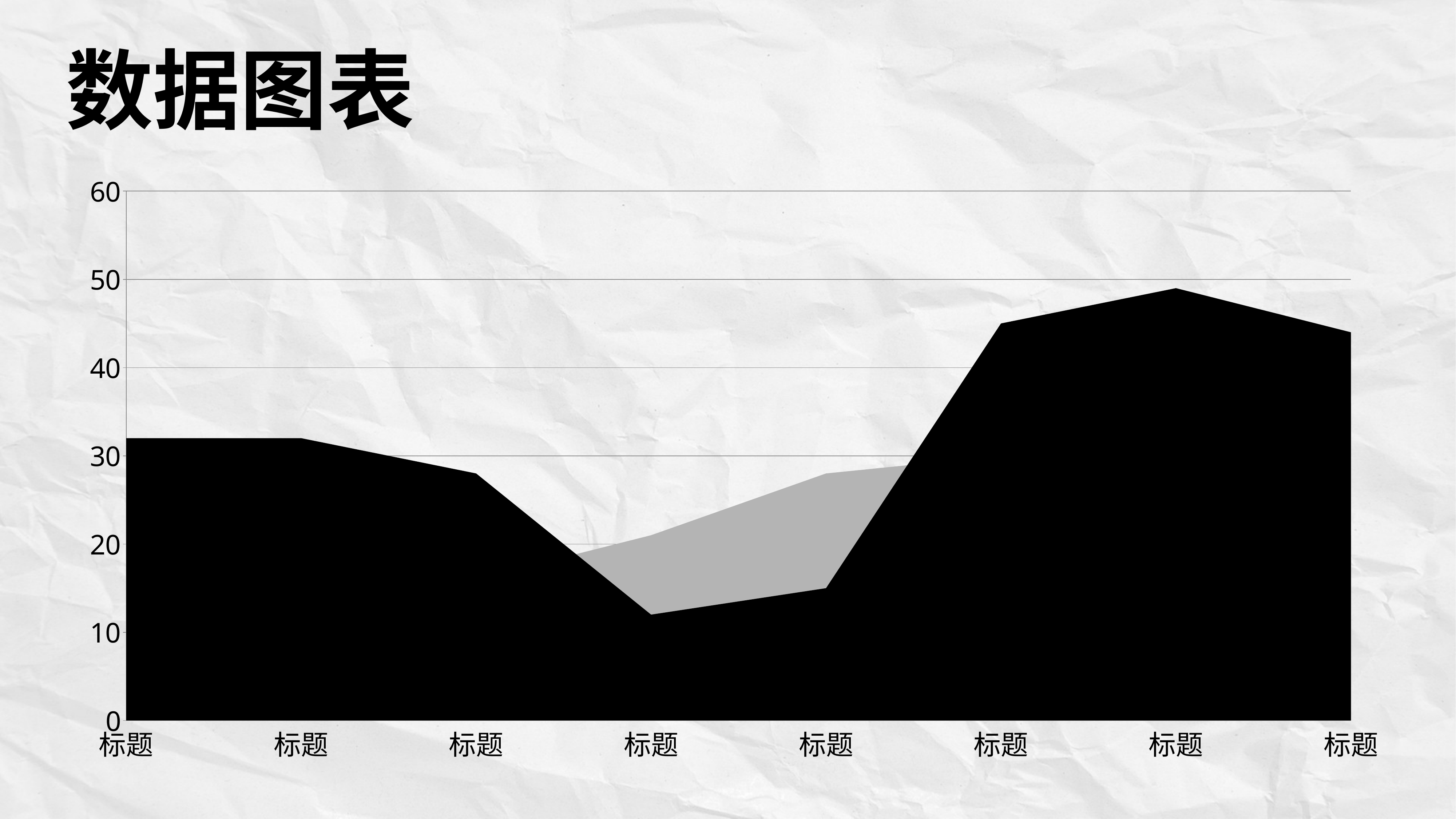
Is the value of the black series at the first category greater or less than 30? greater Is the value of the grey series at the fifth category greater or less than 20? greater Is the value of the black series at the seventh category greater or less than 40? greater What label is shown for each category on the x axis? 标题 At the fifth category, which series has the higher value, the black or the grey one? grey Does the black series rise or fall from the fourth category to the seventh category? rise What is the title of the slide above the chart? 数据图表 At which category position does the black series reach its lowest value? fourth What kind of chart is shown on the slide? area chart How many categories are plotted along the x axis of the chart? 8 At which category position does the black series reach its highest value? seventh